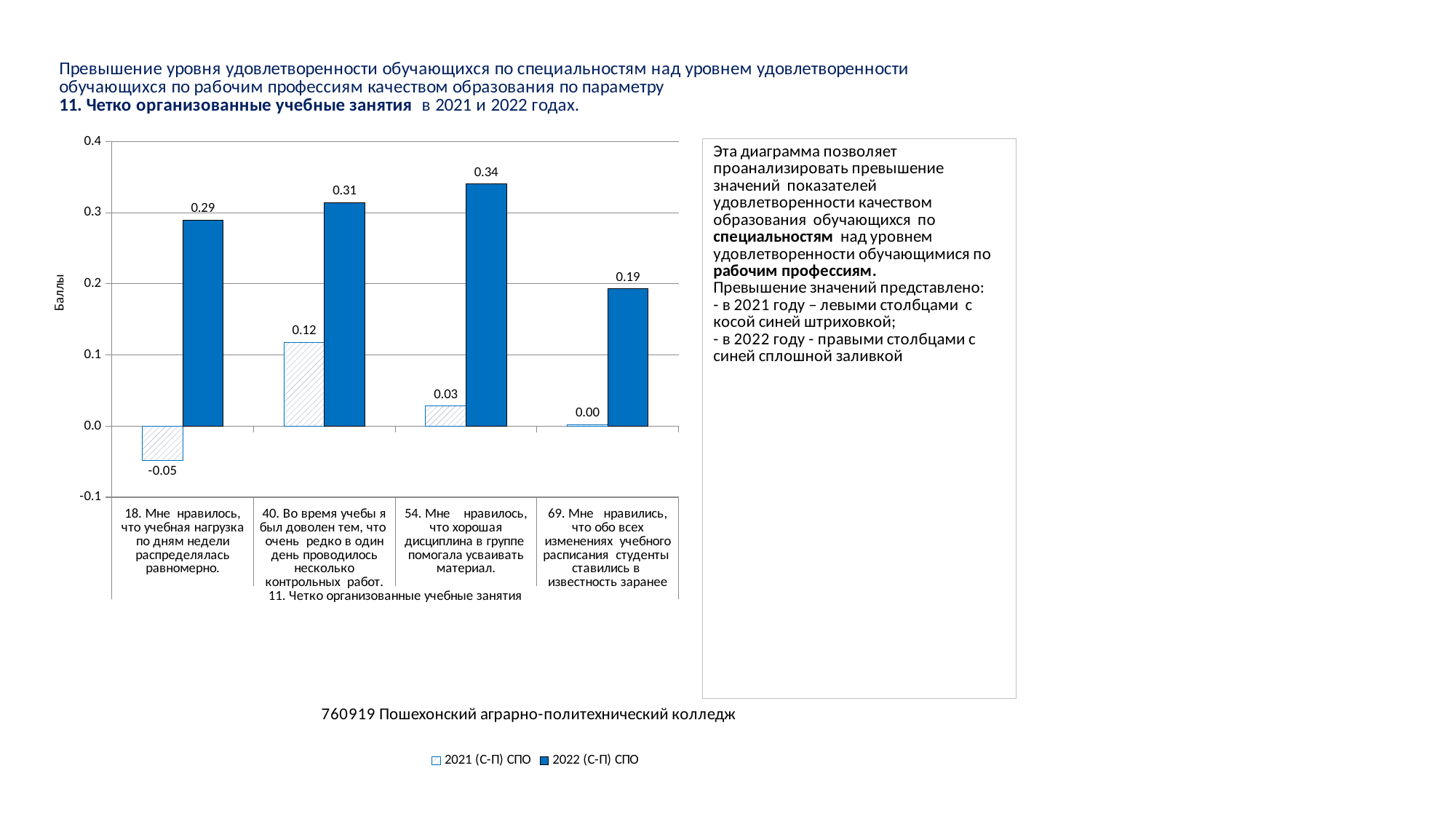
What is the value for the 2022 (С-П) СПО series for category 54 ("Мне нравилось, что хорошая дисциплина в группе помогала усваивать материал")? 0.34 Which is larger for category 18: the 2021 (С-П) СПО value or the 2022 (С-П) СПО value? 2022 (С-П) СПО What is the difference between the 2022 and 2021 values for category 40? 0.19 What is the label of the vertical axis of the chart? Баллы What type of chart is shown on the slide? Bar chart What is the value for the 2021 (С-П) СПО series for category 18 ("Мне нравилось, что учебная нагрузка по дням недели распределялась равномерно")? -0.05 Which category has the lowest value in the 2021 (С-П) СПО series? 18. Мне нравилось, что учебная нагрузка по дням недели распределялась равномерно. What is the value for the 2022 (С-П) СПО series for category 69 ("Мне нравились, что обо всех изменениях учебного расписания студенты ставились в известность заранее")? 0.19 How many series does the chart legend list? 2 What is the value for the 2021 (С-П) СПО series for category 40 ("Во время учебы я был доволен тем, что очень редко в один день проводилось несколько контрольных работ")? 0.12 How many categories are shown on the x axis of the chart? 4 Which category has the highest value in the 2022 (С-П) СПО series? 54. Мне нравилось, что хорошая дисциплина в группе помогала усваивать материал.